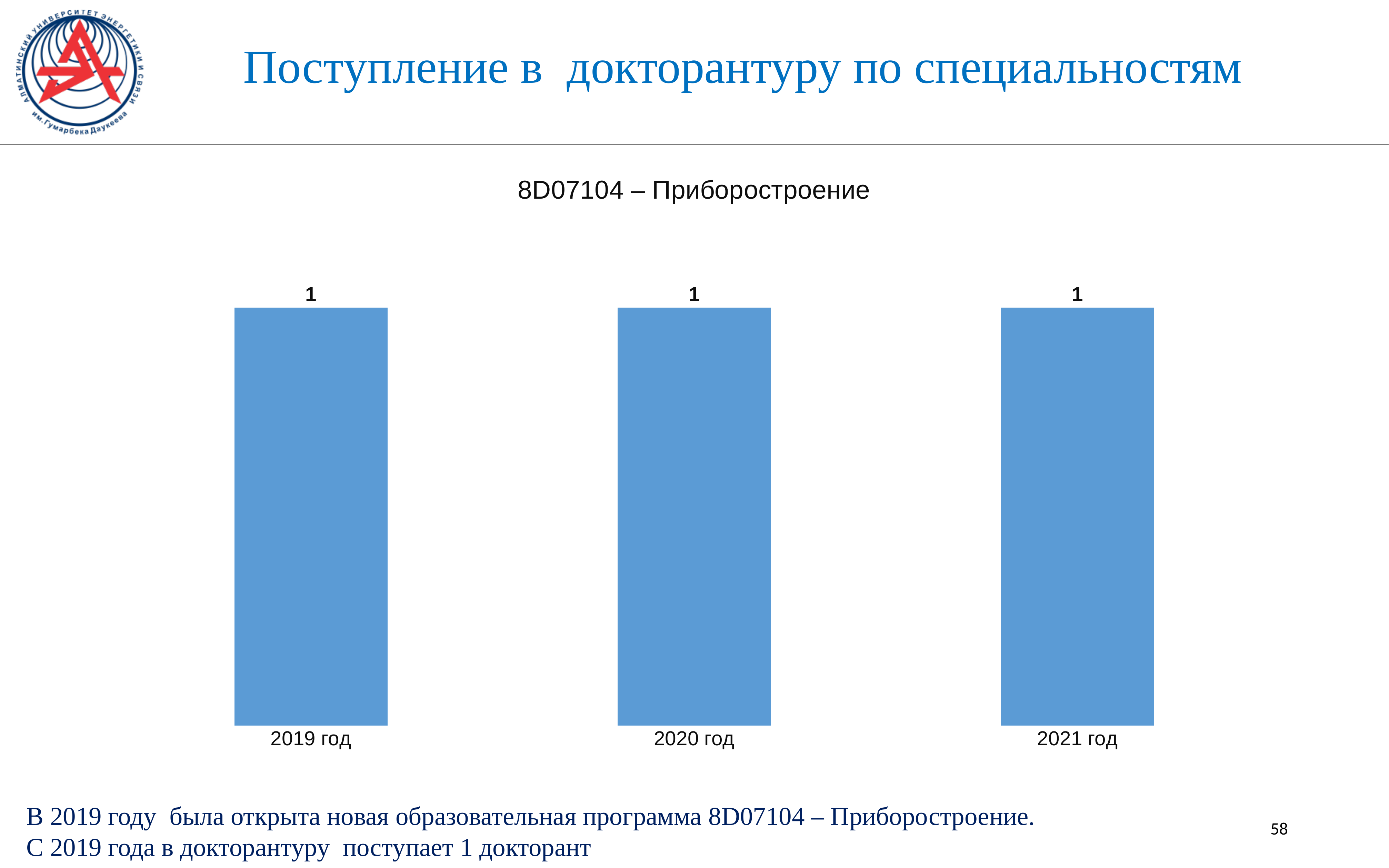
What is the total of the values for 2019 год, 2020 год and 2021 год? 3 What colour are the bars in the chart? blue What is the value for 2020 год? 1 How many categories are shown on the x axis? 3 What is the value for 2021 год? 1 What kind of chart is shown on the slide? bar chart What is the difference between the values for 2019 год and 2021 год? 0 What is the value for 2019 год? 1 Do the values rise, fall, or stay the same from 2019 год to 2021 год? stay the same What is the title of the chart? 8D07104 – Приборостроение